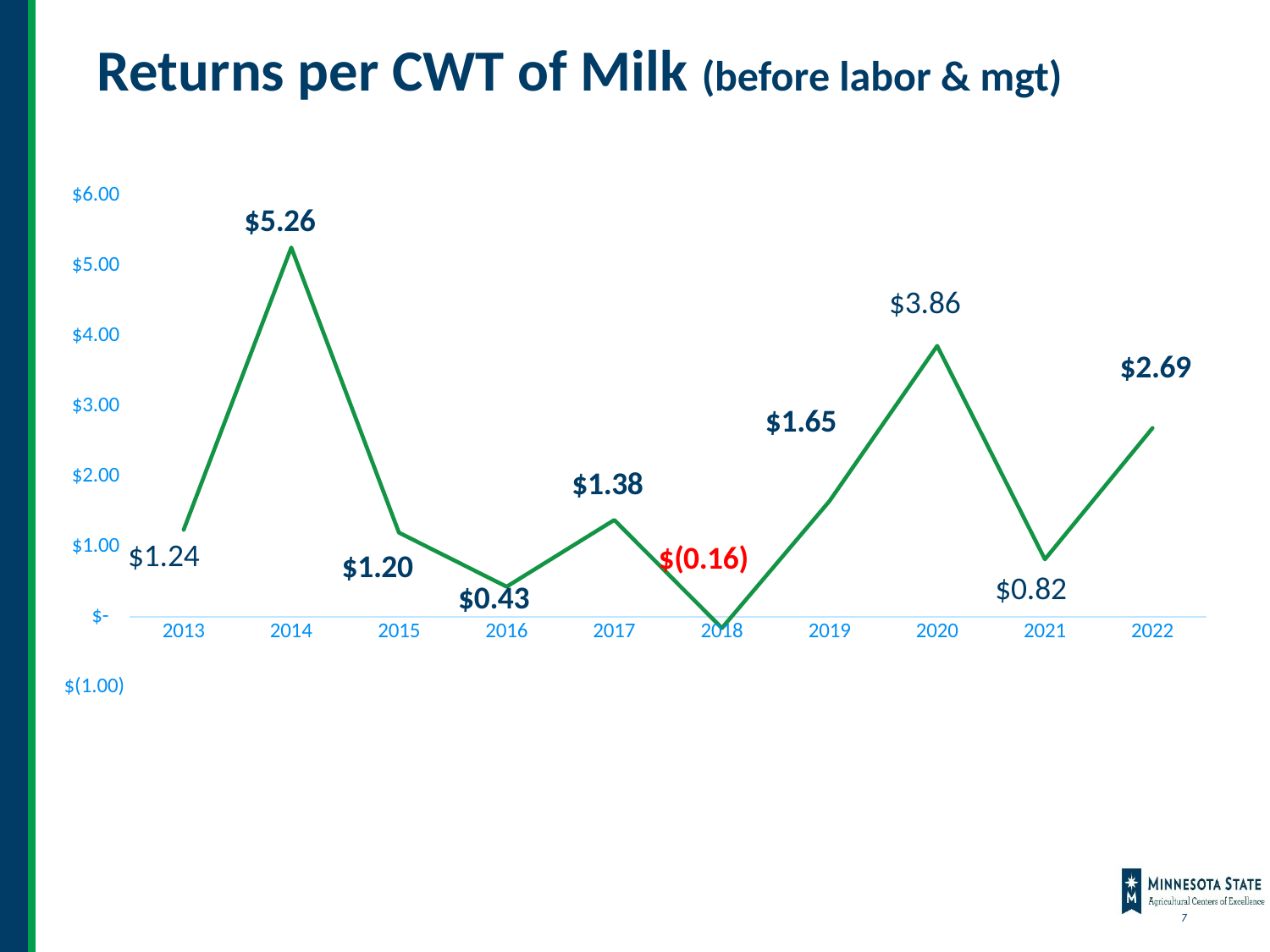
What is the title of the chart? Returns per CWT of Milk (before labor & mgt) What kind of chart is shown on the slide? Line chart What is the return per CWT of milk in 2016? $0.43 What is the return per CWT of milk in 2014? $5.26 Which year has the lowest return per CWT of milk? 2018 What is the return per CWT of milk in 2022? $2.69 What is the return per CWT of milk in 2018? $(0.16) How many years are plotted on the chart? 10 What is the difference between the return per CWT in 2020 and in 2021? $3.04 Which year has the highest return per CWT of milk? 2014 Does the return per CWT of milk rise or fall from 2018 to 2020? Rise Which year has a higher return per CWT of milk, 2013 or 2015? 2013